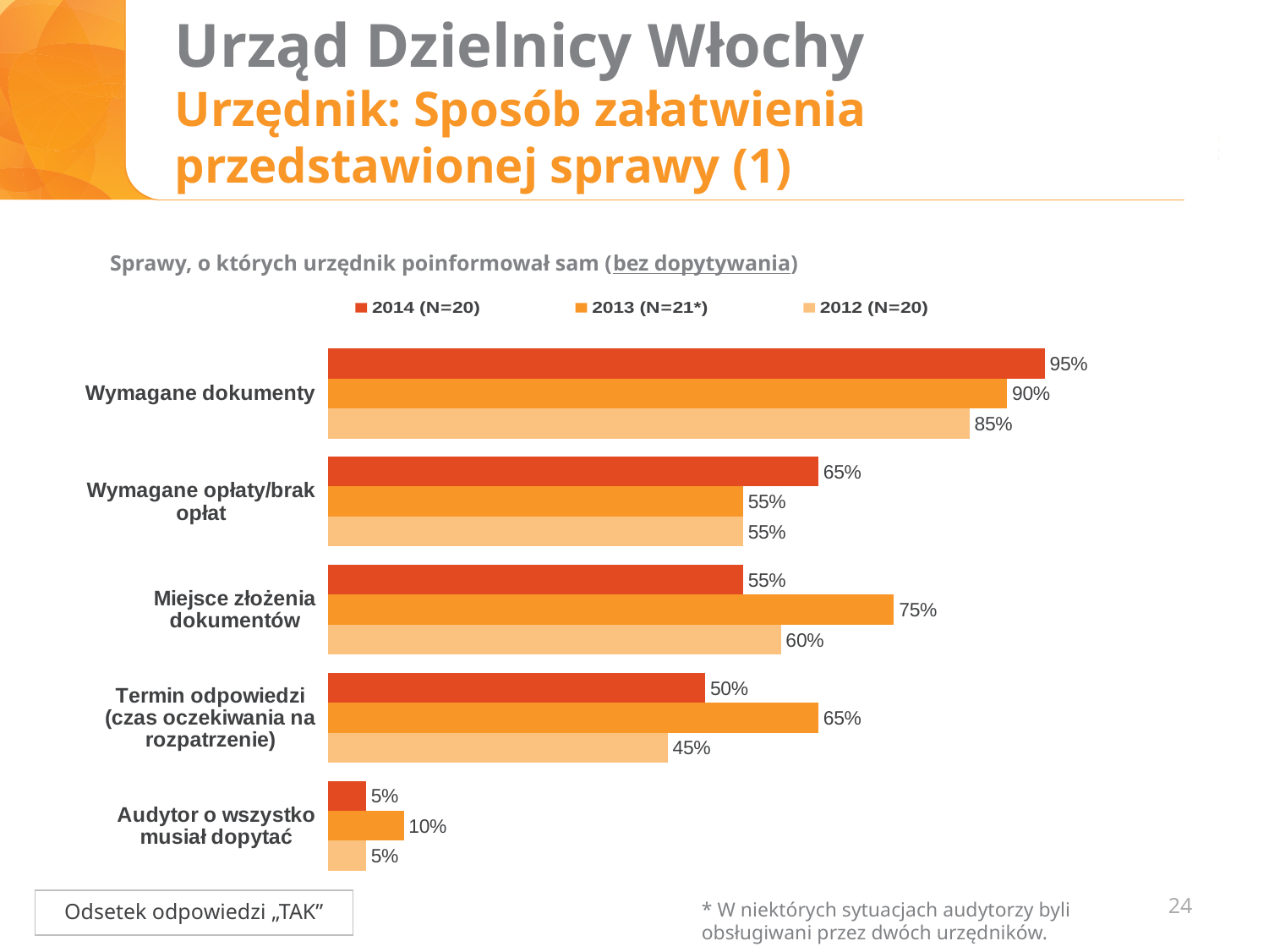
What is the value for "Miejsce złożenia dokumentów" in the 2013 (N=21*) series? 75% What is the sample size shown in the legend for the 2013 series? N=21* Which category has the lowest value in the 2013 (N=21*) series? Audytor o wszystko musiał dopytać What is the difference between the 2014 and 2012 values for "Wymagane dokumenty"? 10% For "Miejsce złożenia dokumentów", which is larger: the 2014 value or the 2013 value? 2013 Which category has the highest value in the 2014 (N=20) series? Wymagane dokumenty What is the difference between the 2013 and 2014 values for "Termin odpowiedzi (czas oczekiwania na rozpatrzenie)"? 15% What is the value for "Wymagane dokumenty" in the 2014 (N=20) series? 95% How many categories are shown on the chart? 5 What is the value for "Termin odpowiedzi (czas oczekiwania na rozpatrzenie)" in the 2012 (N=20) series? 45% How many series does the legend list? 3 What kind of chart is shown on the slide? bar chart